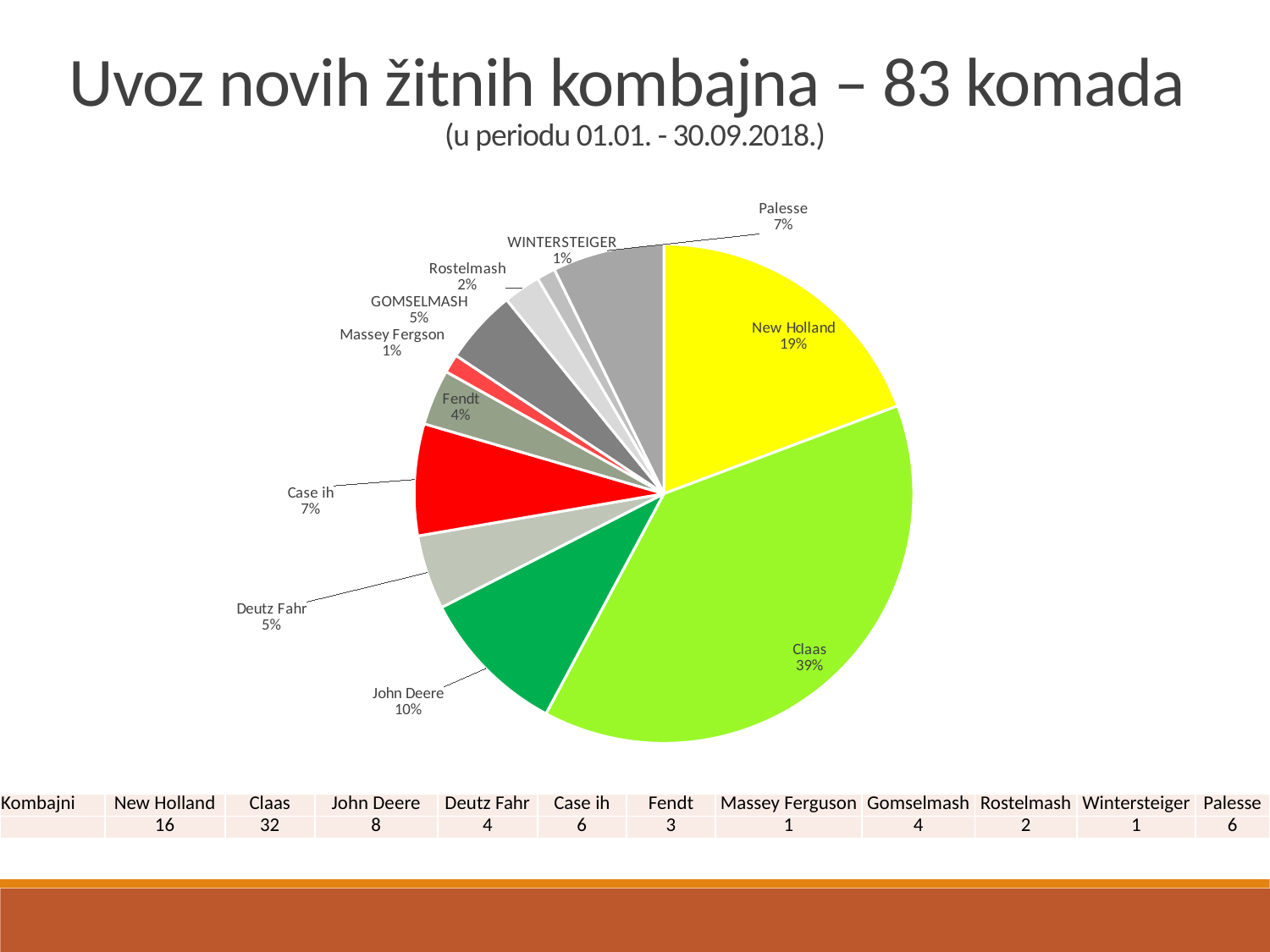
Which brand has the largest slice of the pie chart? Claas What percentage share does John Deere have in the pie chart? 10% What is the difference in percentage points between the Claas slice and the New Holland slice? 20 How many slices (brands) does the pie chart have? 11 According to the table below the chart, how many New Holland combines were imported? 16 According to the table below the chart, how many Claas combines were imported? 32 What percentage share does Palesse have in the pie chart? 7% What percentage share does Claas have in the pie chart? 39% What is the title of the slide containing the pie chart? Uvoz novih žitnih kombajna – 83 komada What kind of chart is shown on the slide? pie chart Which slice is larger, Case ih or Fendt? Case ih What percentage share does New Holland have in the pie chart? 19%